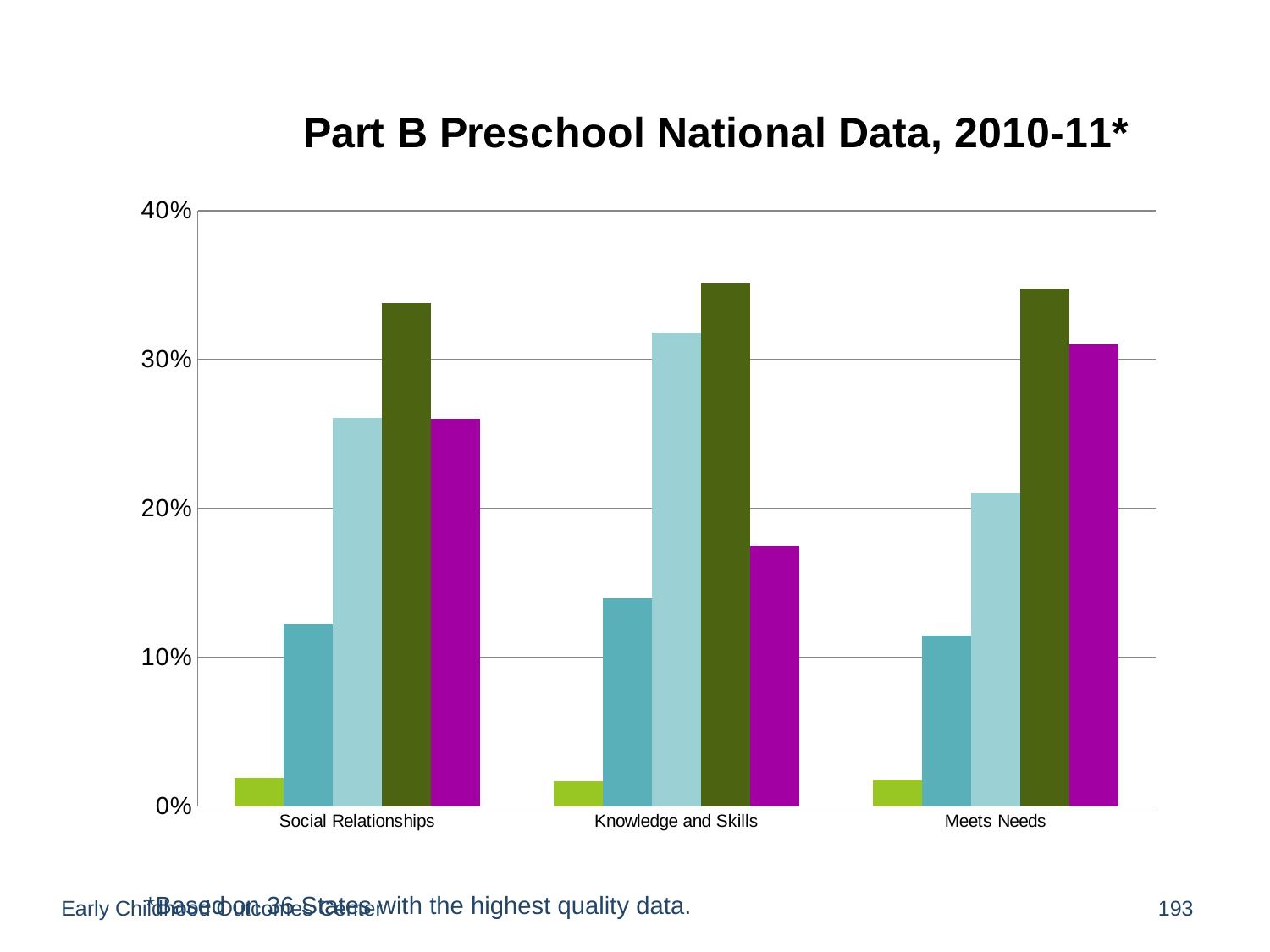
Is the value of the teal bar for Social Relationships greater or less than 10%? greater Is the value of the purple bar for Knowledge and Skills greater or less than 20%? less What does the asterisk footnote at the bottom of the slide say? Based on 36 States with the highest quality data. Is the value of the light blue bar for Meets Needs greater or less than 30%? less How many categories are shown along the x axis of the chart? 3 How many bars are plotted for each category in the chart? 5 What is the title of the chart? Part B Preschool National Data, 2010-11* What kind of chart is shown on the slide? bar chart Which coloured bar is the shortest in the Knowledge and Skills category? the lime green bar Which coloured bar is the tallest in the Social Relationships category? the dark green bar In the Knowledge and Skills category, which is larger: the light blue bar or the purple bar? the light blue bar